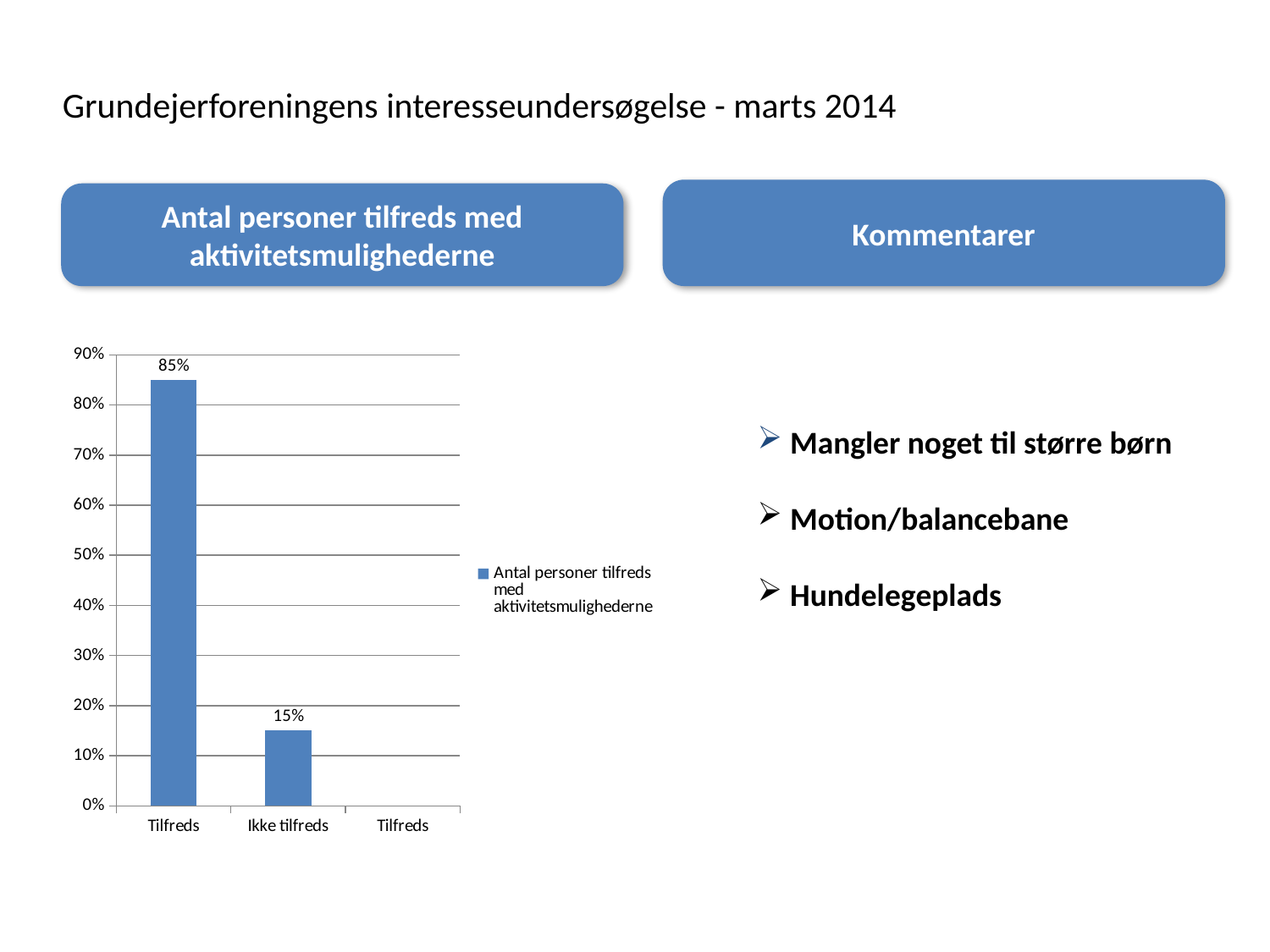
What is the value for Ikke tilfreds in the chart? 15% How many bars are plotted in the chart? 2 What kind of chart is shown on the slide? bar chart Is the value for Ikke tilfreds greater or less than 20%? less Which is larger, the value for Tilfreds or the value for Ikke tilfreds? Tilfreds What is the legend entry of the chart? Antal personer tilfreds med aktivitetsmulighederne Is the value for Tilfreds greater or less than 80%? greater Which category has the highest value in the chart? Tilfreds What is the difference between the values for Tilfreds and Ikke tilfreds? 70% How many series does the chart legend list? 1 What is the value for Tilfreds in the chart? 85% Which plotted bar has the lowest value in the chart? Ikke tilfreds